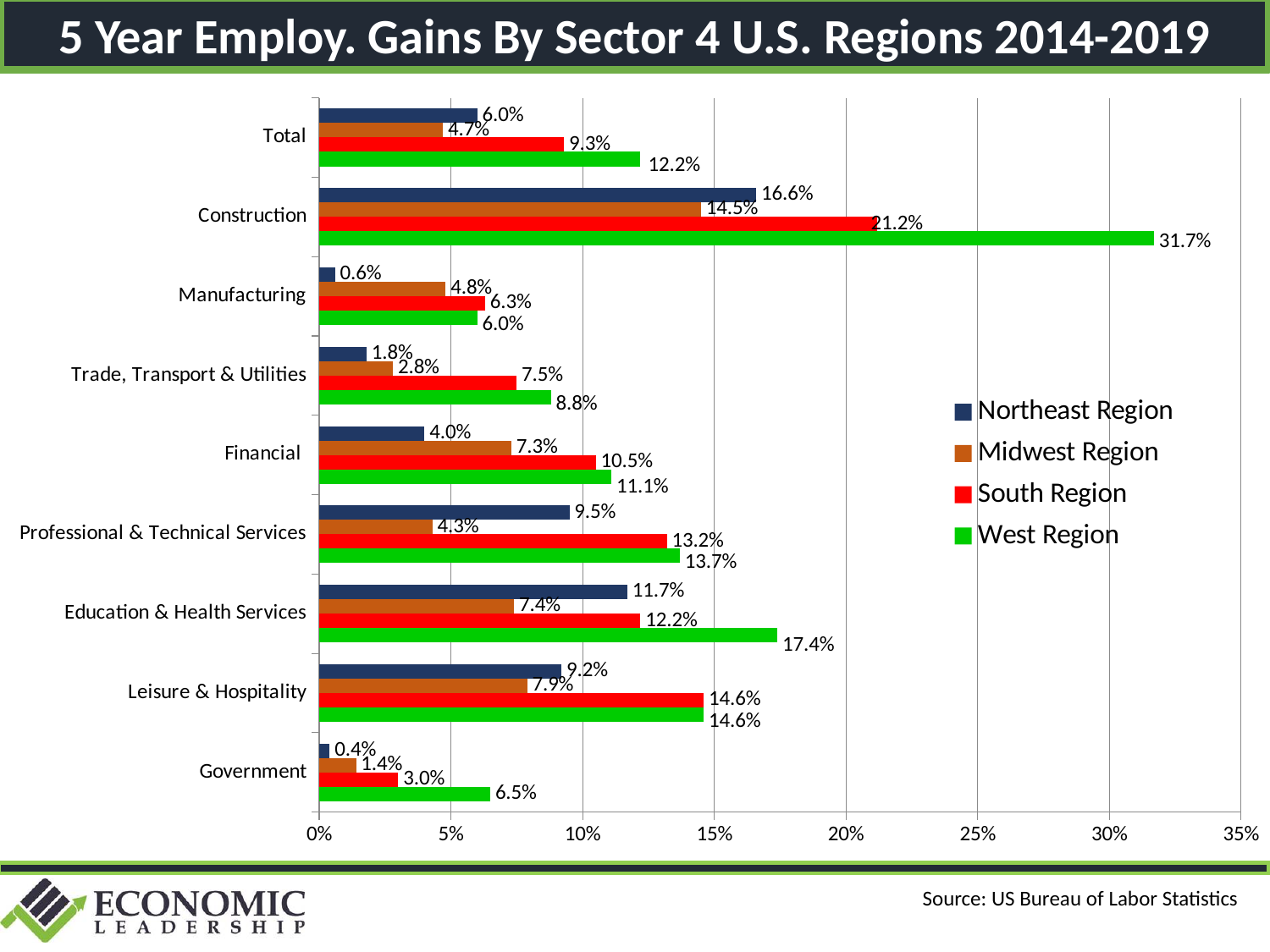
How many sector categories are shown on the chart? 9 Is the South Region value for Construction greater or less than 20%? greater What is the Northeast Region value for Manufacturing? 0.6% Which is larger for Professional & Technical Services: the Northeast Region value or the Midwest Region value? Northeast Region Which sector has the lowest Northeast Region value? Government How many series does the legend list? 4 What is the Midwest Region value for Government? 1.4% What is the South Region value for Financial? 10.5% Which sector has the highest West Region value? Construction What kind of chart is shown on the slide? Bar chart What is the West Region value for Construction? 31.7% What is the difference between the West Region and Northeast Region values for Education & Health Services? 5.7%